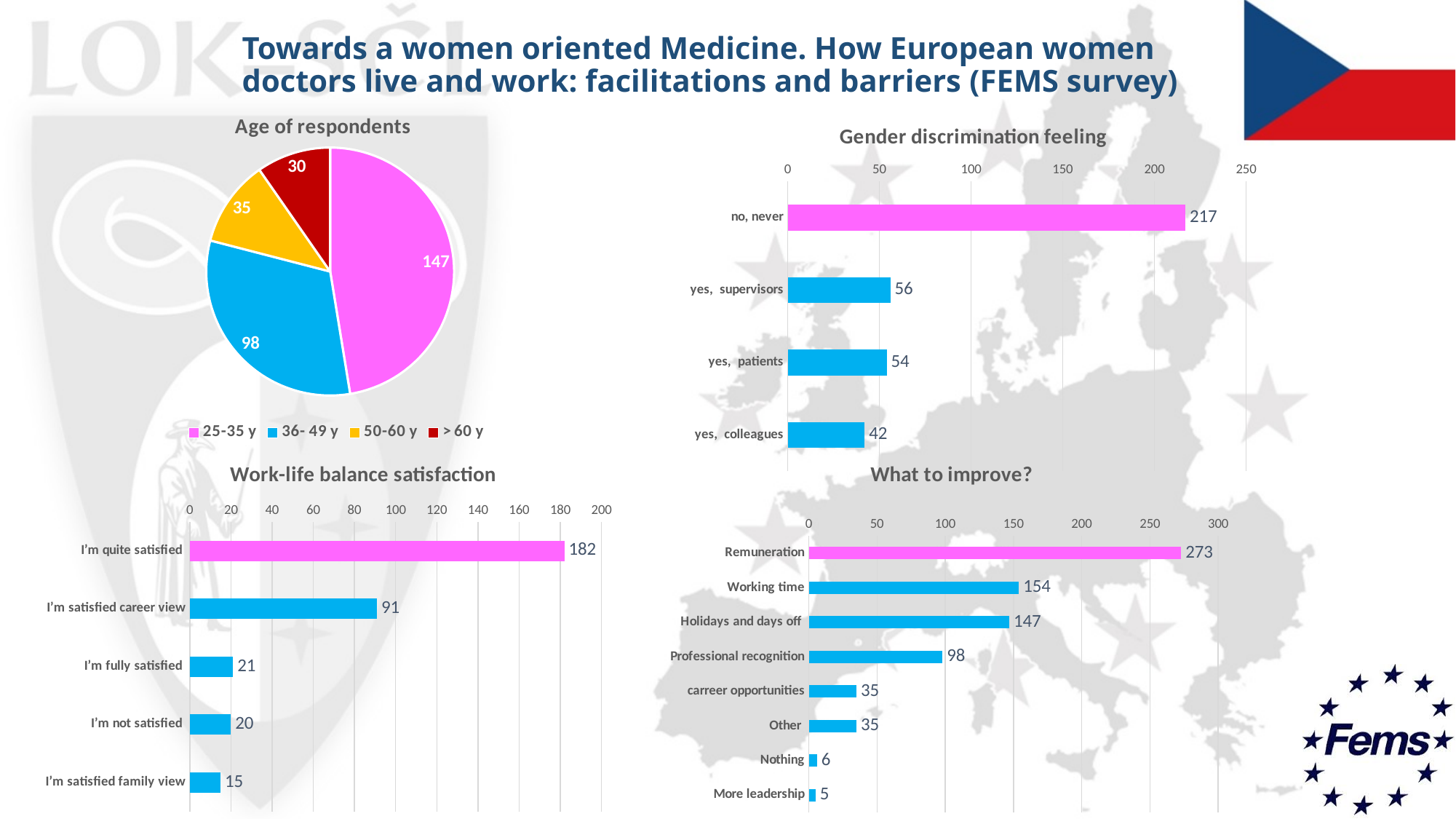
In the 'Age of respondents' pie chart, which age group has the smallest slice? > 60 y In the 'Gender discrimination feeling' chart, what is the difference between 'yes, supervisors' and 'yes, colleagues'? 14 How many age groups does the legend of the 'Age of respondents' pie chart list? 4 In the 'What to improve?' chart, which is larger: 'Working time' or 'Holidays and days off'? Working time In the 'Age of respondents' pie chart, what is the value for the 36- 49 y slice? 98 In the 'Work-life balance satisfaction' chart, which category has the lowest value? I'm satisfied family view What kind of chart is 'Gender discrimination feeling'? bar chart In the 'Work-life balance satisfaction' chart, what is the value for 'I'm satisfied career view'? 91 In the 'What to improve?' chart, what is the value for 'Professional recognition'? 98 How many categories are shown in the 'Work-life balance satisfaction' chart? 5 In the 'Gender discrimination feeling' chart, what is the value for 'no, never'? 217 In the 'What to improve?' chart, which category has the highest value? Remuneration